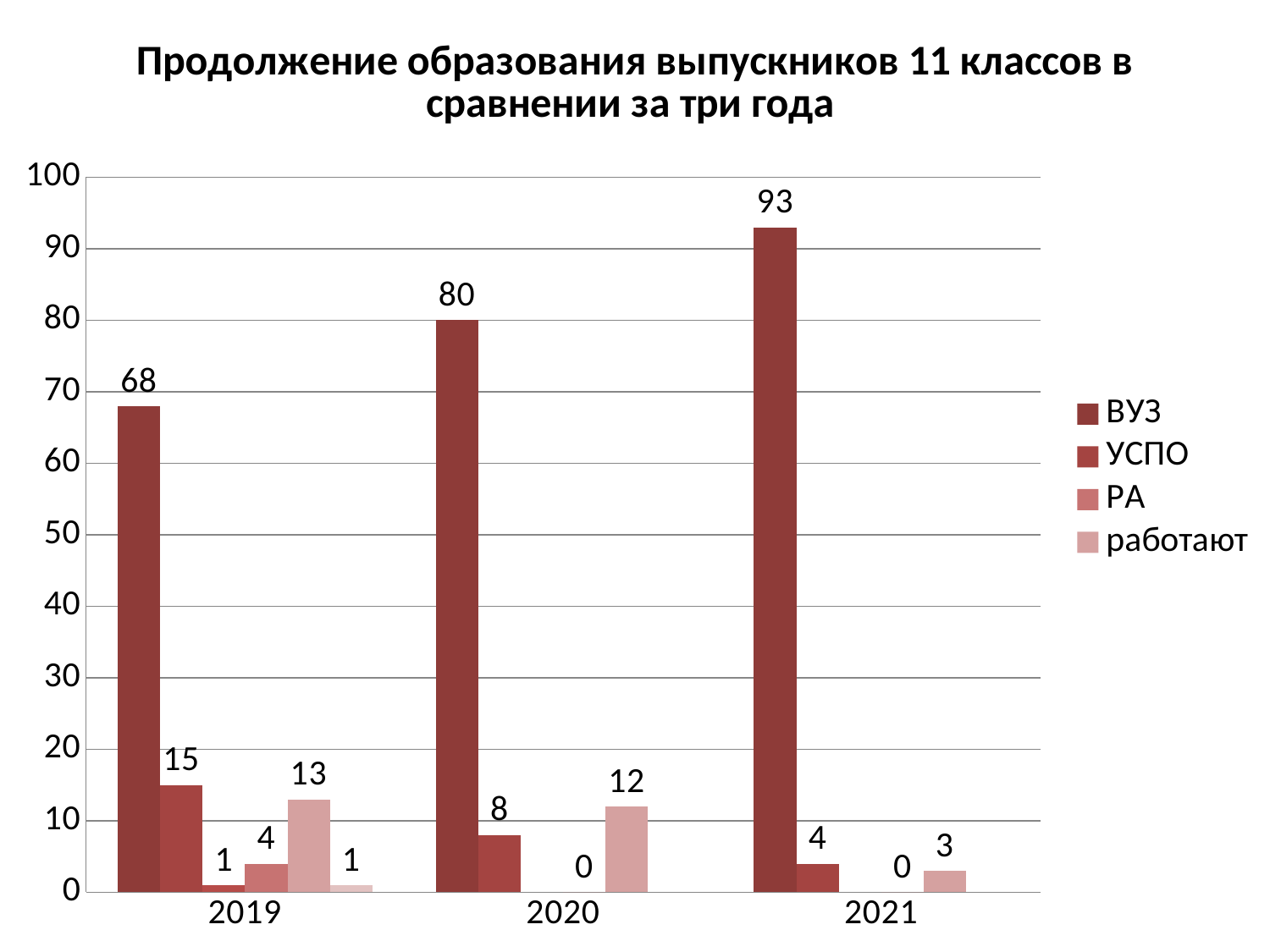
In which year is the ВУЗ value highest? 2021 What is the title of the chart? Продолжение образования выпускников 11 классов в сравнении за три года What kind of chart is shown on the slide? bar chart Do the ВУЗ values rise or fall from 2019 to 2021? rise What is the difference between the ВУЗ values for 2021 and 2019? 25 What is the value for УСПО in 2019? 15 Which is larger in 2020, the ВУЗ value or the УСПО value? ВУЗ What is the value for ВУЗ in 2020? 80 What is the value for ВУЗ in 2021? 93 How many years are shown on the x axis? 3 What is the value for ВУЗ in 2019? 68 How many series does the legend list? 4